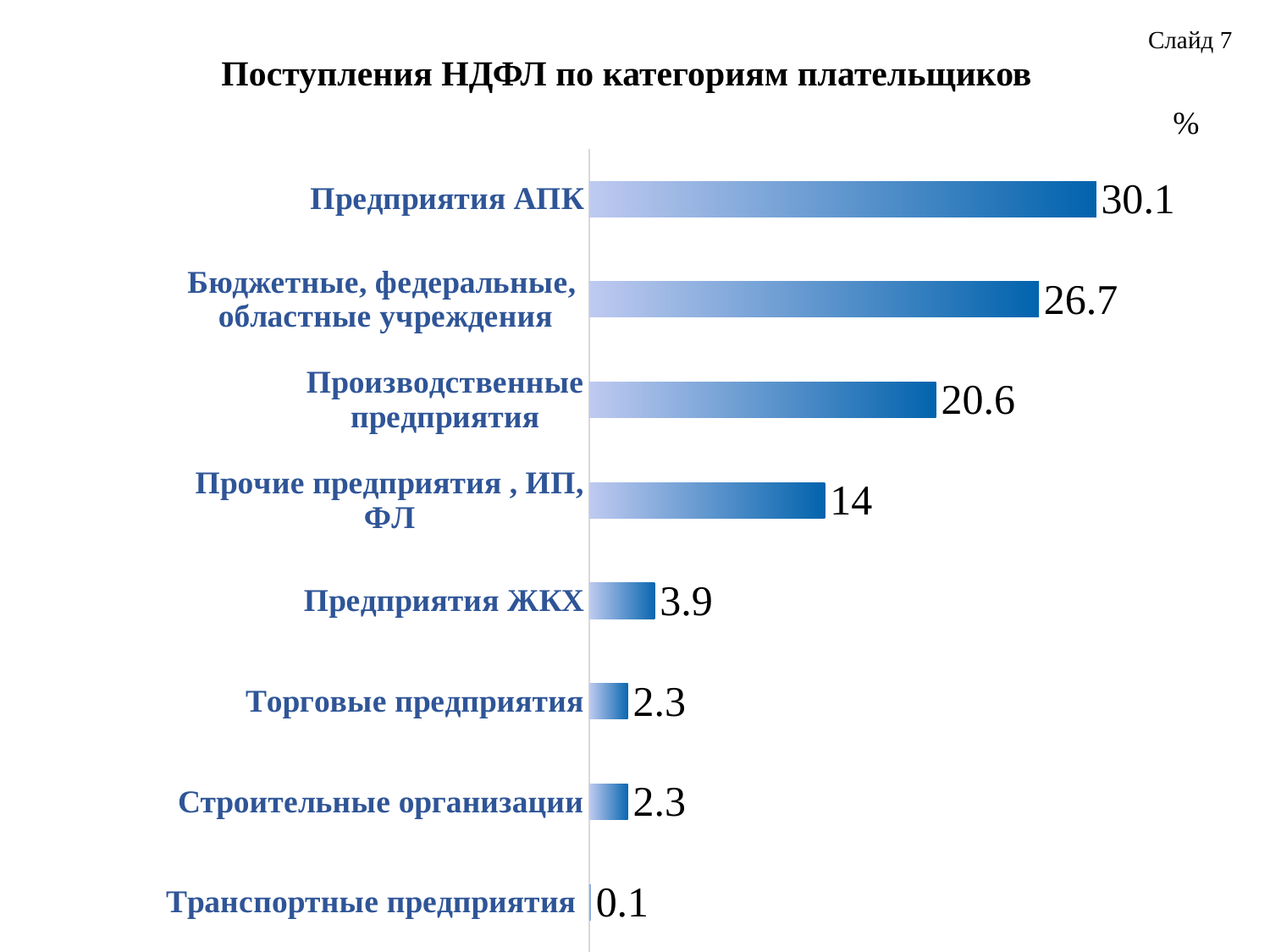
What kind of chart is this? Bar chart Which is larger: Предприятия ЖКХ or Торговые предприятия? Предприятия ЖКХ What is the value for Предприятия ЖКХ? 3.9 How many categories are shown in the chart? 8 What is the value for Производственные предприятия? 20.6 What is the title of the chart? Поступления НДФЛ по категориям плательщиков What is the difference between Предприятия АПК and Бюджетные, федеральные, областные учреждения? 3.4 What is the value for Предприятия АПК? 30.1 What is the difference between Производственные предприятия and Прочие предприятия, ИП, ФЛ? 6.6 What is the value for Транспортные предприятия? 0.1 Which category has the lowest value? Транспортные предприятия Which category has the highest value? Предприятия АПК